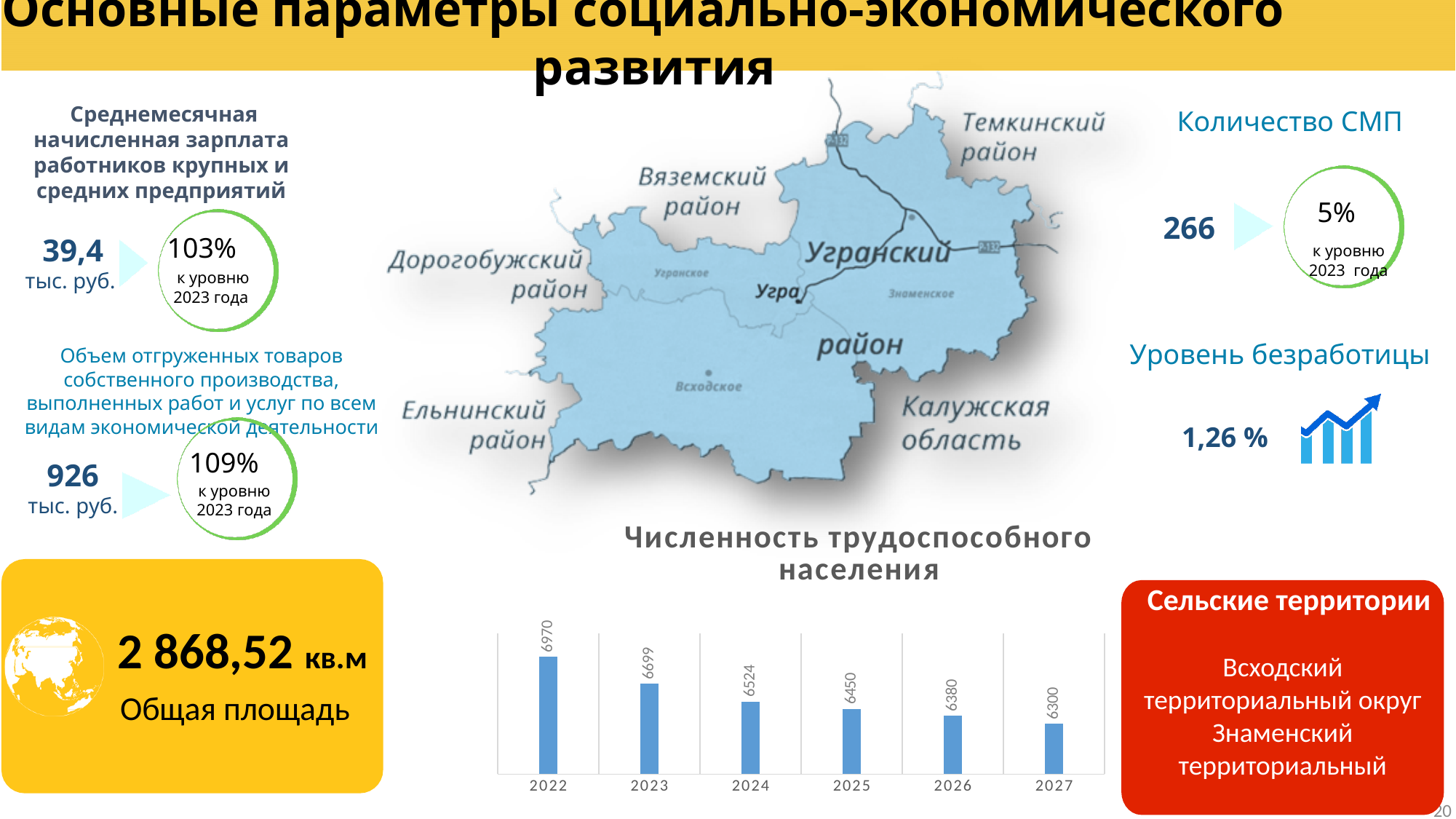
What is the value for 2022 in the 'Численность трудоспособного населения' chart? 6970 Which year has the lowest value in the 'Численность трудоспособного населения' chart? 2027 What is the difference between the 2024 and 2027 values in the 'Численность трудоспособного населения' chart? 224 What kind of chart is 'Численность трудоспособного населения'? bar chart What is the value for 2027 in the 'Численность трудоспособного населения' chart? 6300 Which year has the highest value in the 'Численность трудоспособного населения' chart? 2022 What is the title of the bar chart on the slide? Численность трудоспособного населения Do the values in the 'Численность трудоспособного населения' chart rise or fall from 2022 to 2027? fall What is the difference between the 2022 and 2023 values in the 'Численность трудоспособного населения' chart? 271 What is the value for 2025 in the 'Численность трудоспособного населения' chart? 6450 In the 'Численность трудоспособного населения' chart, which is larger: the value for 2023 or the value for 2026? 2023 How many years are shown in the 'Численность трудоспособного населения' chart? 6